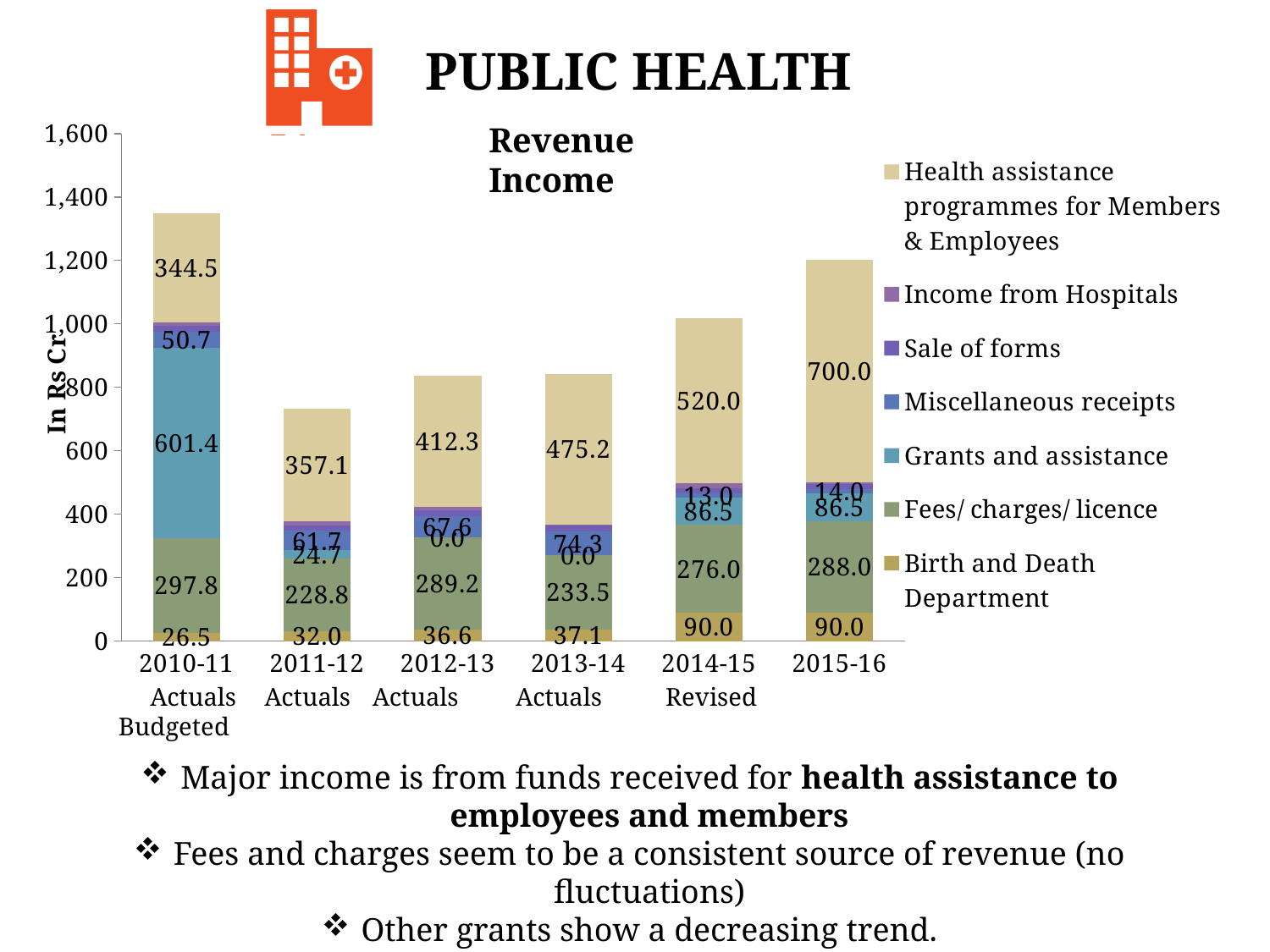
What kind of chart is shown on the slide? Stacked bar chart What is the value for Fees/ charges/ licence in 2012-13? 289.2 In which year is the Birth and Death Department value lowest? 2010-11 What is the value for Birth and Death Department in 2010-11? 26.5 In which year is the Health assistance programmes for Members & Employees value highest? 2015-16 What is the difference between the Health assistance programmes values for 2015-16 and 2014-15? 180.0 What is the value for Grants and assistance in 2010-11? 601.4 What is the label on the vertical axis of the chart? In Rs Cr How many years (categories) are shown on the x axis of the Revenue Income chart? 6 What is the value for Health assistance programmes for Members & Employees in 2015-16? 700.0 Is the total height of the 2010-11 stacked bar greater or less than 1,200? greater How many series does the legend of the Revenue Income chart list? 7